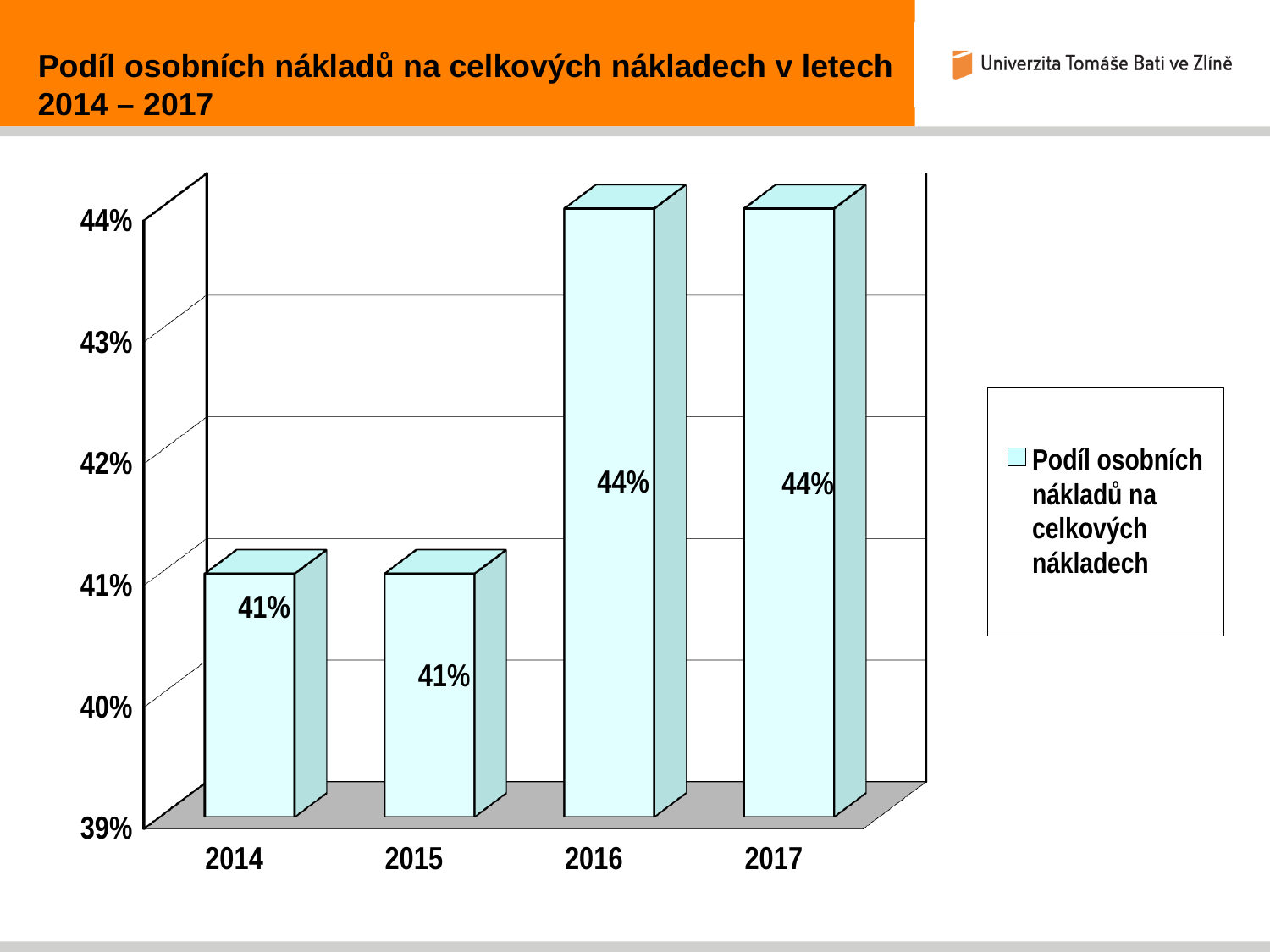
What is the value for 2014? 41% What is the value for 2016? 44% How many years are shown on the x axis? 4 Which is larger, the value for 2015 or the value for 2017? 2017 What is the value for 2017? 44% Is the value for 2016 greater or less than 42%? greater Is the value for 2014 greater or less than 43%? less Do the values rise or fall from 2014 to 2017? rise What kind of chart is shown on the slide? bar chart What is the difference between the value for 2016 and the value for 2014? 3% What is the value for 2015? 41% How many series does the legend list? 1